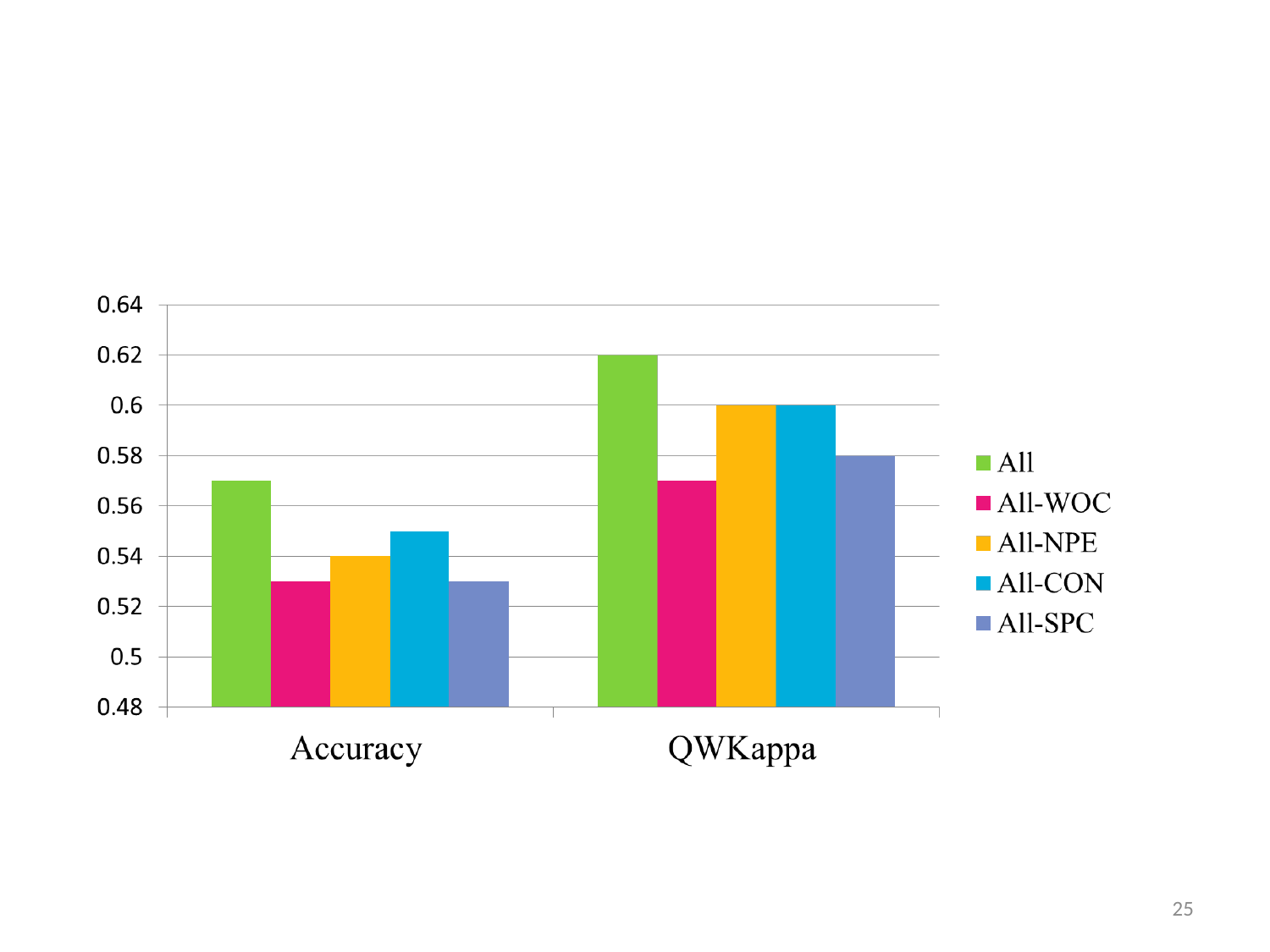
Which series has the highest QWKappa value? All Is the Accuracy value for All greater or less than 0.56? greater Is the Accuracy value for All-WOC greater or less than 0.54? less How many series does the legend list? 5 Which series has the highest Accuracy value? All What is the Accuracy value for All-NPE? 0.54 What kind of chart is shown on the slide? Bar chart Which is larger: the Accuracy value for All or for All-WOC? All What is the QWKappa value for the All series? 0.62 What is the QWKappa value for All-CON? 0.6 What is the QWKappa value for All-SPC? 0.58 What is the difference between the QWKappa values of All and All-SPC? 0.04